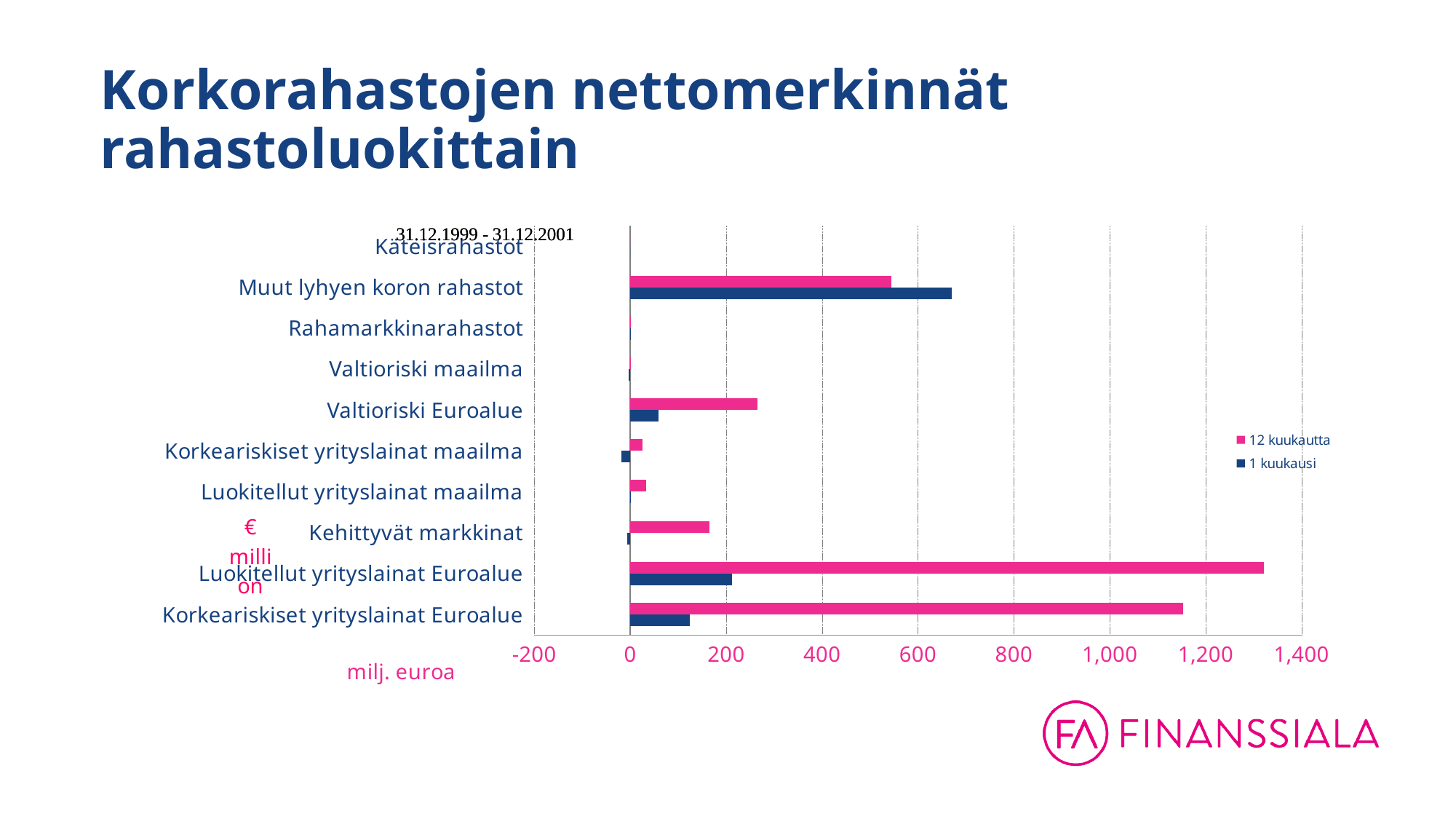
What kind of chart is shown on the slide? bar chart How many series does the legend list? 2 Is the 1 kuukausi value for Muut lyhyen koron rahastot greater or less than 600? greater Which category has the highest value for the 12 kuukautta series? Luokitellut yrityslainat Euroalue How many fund categories are shown on the vertical axis? 10 Is the 12 kuukautta value for Korkeariskiset yrityslainat Euroalue greater or less than 1,000? greater What unit is shown below the horizontal axis of the chart? milj. euroa Is the 12 kuukautta value for Luokitellut yrityslainat Euroalue greater or less than 1,200? greater Which category has the highest value for the 1 kuukausi series? Muut lyhyen koron rahastot For Muut lyhyen koron rahastot, which series has the larger value, 12 kuukautta or 1 kuukausi? 1 kuukausi For Luokitellut yrityslainat Euroalue, which series has the larger value, 12 kuukautta or 1 kuukausi? 12 kuukautta